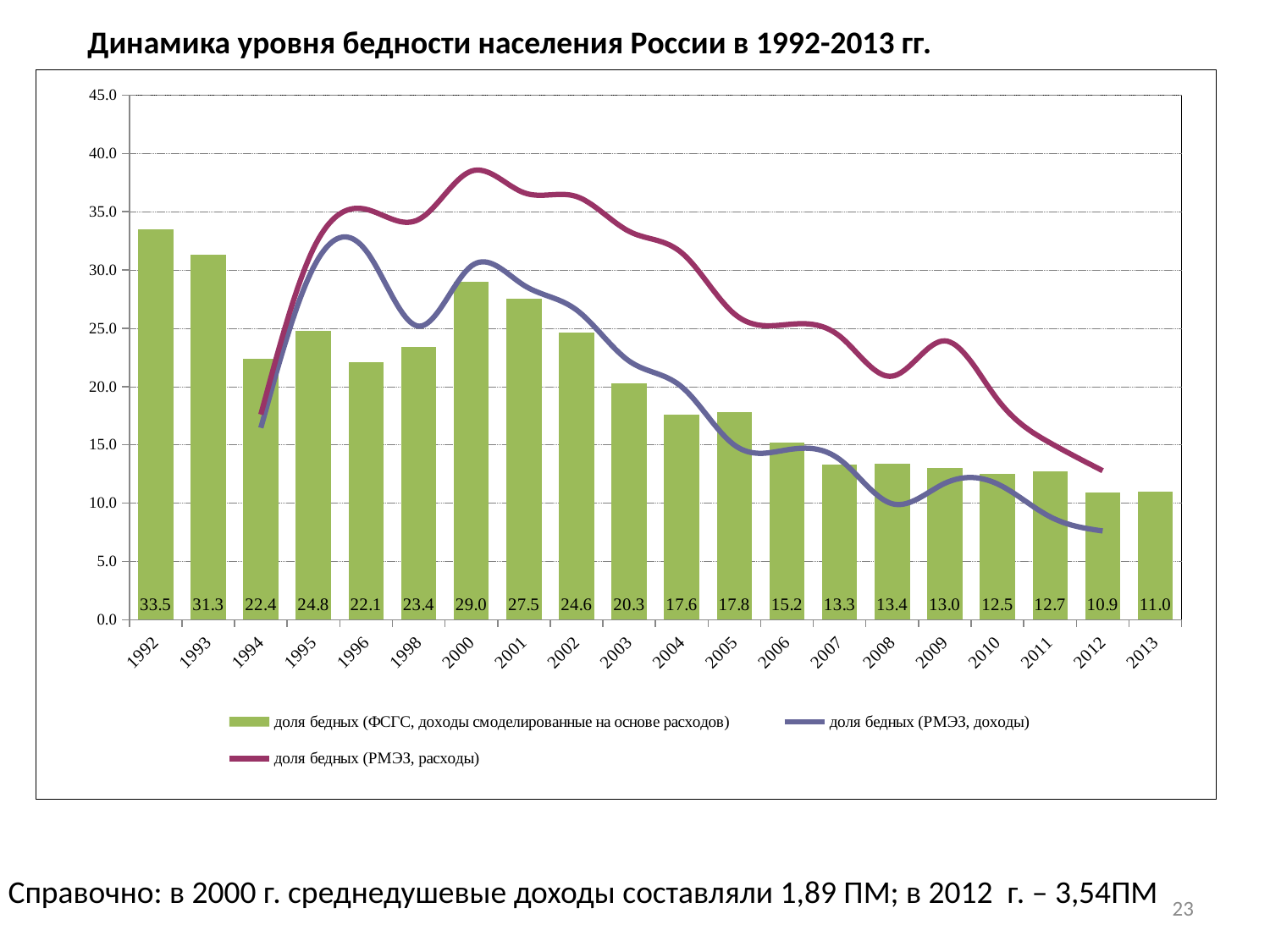
Which year has the highest bar value (доля бедных, ФСГС)? 1992 What is the difference between the bar values for 1992 and 2013? 22.5 How many years (categories) are shown on the x axis? 20 What is the value of the bar (доля бедных, ФСГС) for 2000? 29.0 Is the value of the line 'доля бедных (РМЭЗ, расходы)' for 2000 greater or less than 35.0? greater What is the value of the bar (доля бедных, ФСГС) for 1992? 33.5 Which year has the lowest bar value (доля бедных, ФСГС)? 2012 How many series does the legend list? 3 Is the value of the line 'доля бедных (РМЭЗ, доходы)' for 2012 greater or less than 10.0? less What is the value of the bar (доля бедных, ФСГС) for 2013? 11.0 What kind of chart is shown on the slide? Combined bar and line chart Which bar value is larger, 2004 or 2005? 2005